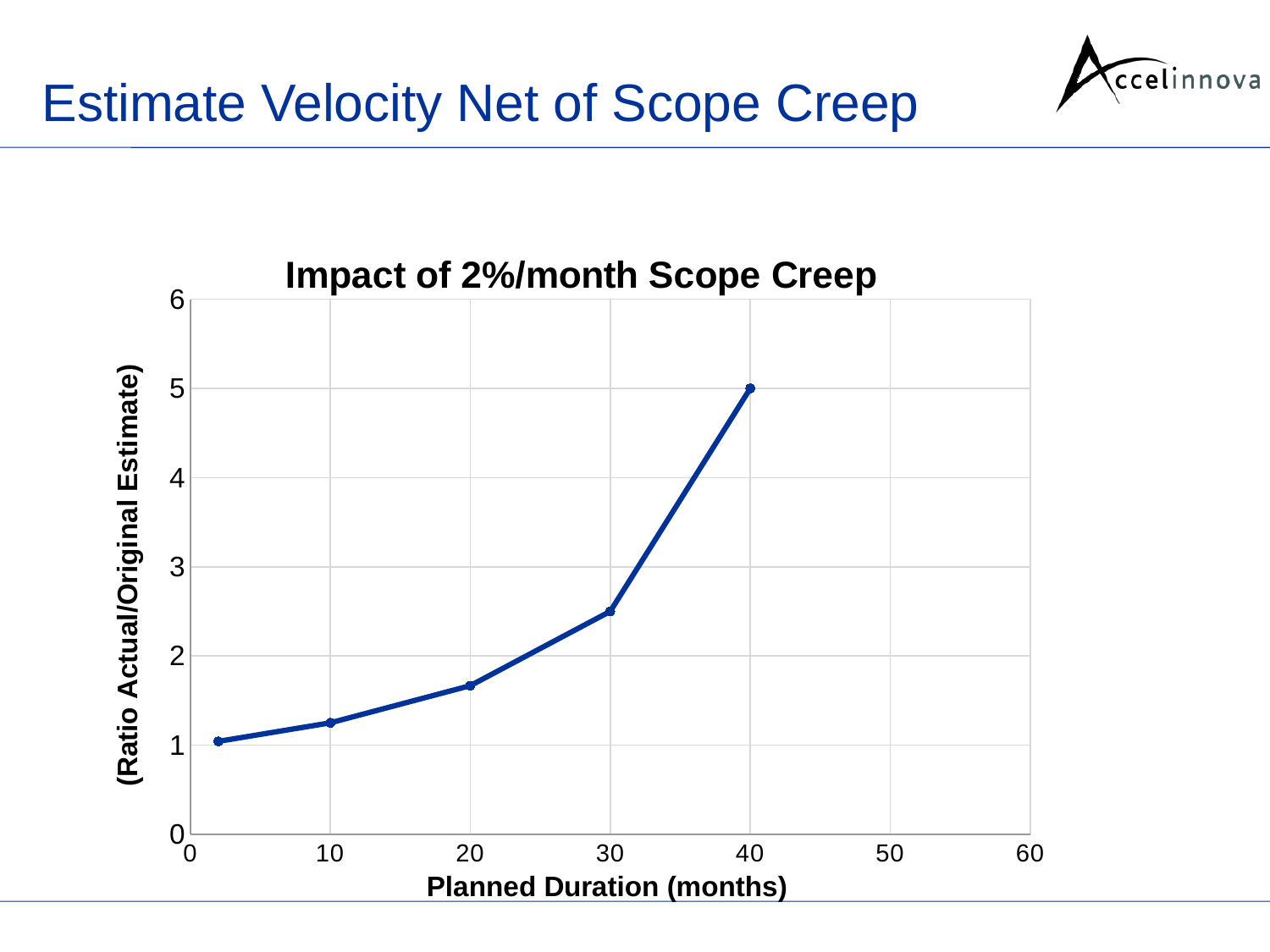
Is the ratio at a planned duration of 10 months greater or less than 2? less At which planned duration is the ratio highest? 40 Does the ratio rise or fall as planned duration increases? rises What is the title of the chart? Impact of 2%/month Scope Creep Which has the larger ratio: a planned duration of 30 months or 20 months? 30 months How many data points are plotted on the line? 5 What is the ratio of actual to original estimate at a planned duration of 40 months? 5 What is the label of the x axis? Planned Duration (months) What kind of chart is shown on the slide? line chart Is the ratio at a planned duration of 20 months greater or less than 2? less Is the ratio at a planned duration of 30 months greater or less than 2? greater